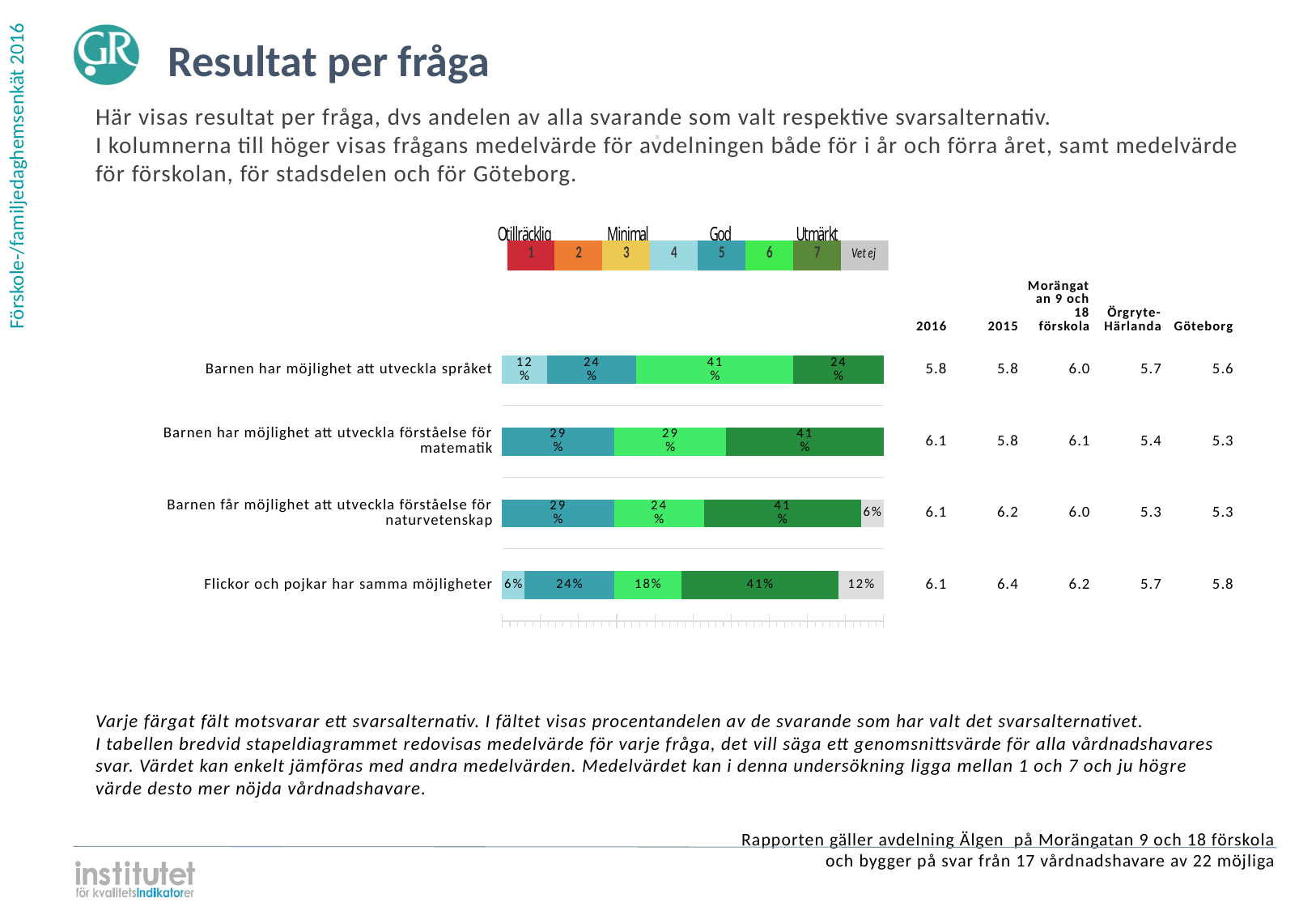
Which question has the largest share of respondents choosing answer 4 (light blue)? Barnen har möjlighet att utveckla språket What percentage of respondents chose answer 7 (dark green) for 'Barnen har möjlighet att utveckla förståelse för matematik'? 41% What is the difference between the answer 7 share (41%) and the answer 6 share (18%) for 'Flickor och pojkar har samma möjligheter'? 23% What percentage of respondents answered 'Vet ej' for 'Flickor och pojkar har samma möjligheter'? 12% How many entries does the colour legend above the chart list? 8 How many questions (categories) are plotted in the bar chart? 4 What is the 2016 mean value shown for 'Barnen har möjlighet att utveckla språket'? 5.8 What label does the legend give to the grey segment at the far right? Vet ej What percentage of respondents chose answer 6 (light green) for 'Barnen har möjlighet att utveckla språket'? 41% What percentage of respondents answered 'Vet ej' for 'Barnen får möjlighet att utveckla förståelse för naturvetenskap'? 6% For 'Barnen har möjlighet att utveckla språket', which is larger: the share for answer 4 (12%) or the share for answer 5 (24%)? Answer 5 (24%) What kind of chart is shown on the slide? Stacked bar chart